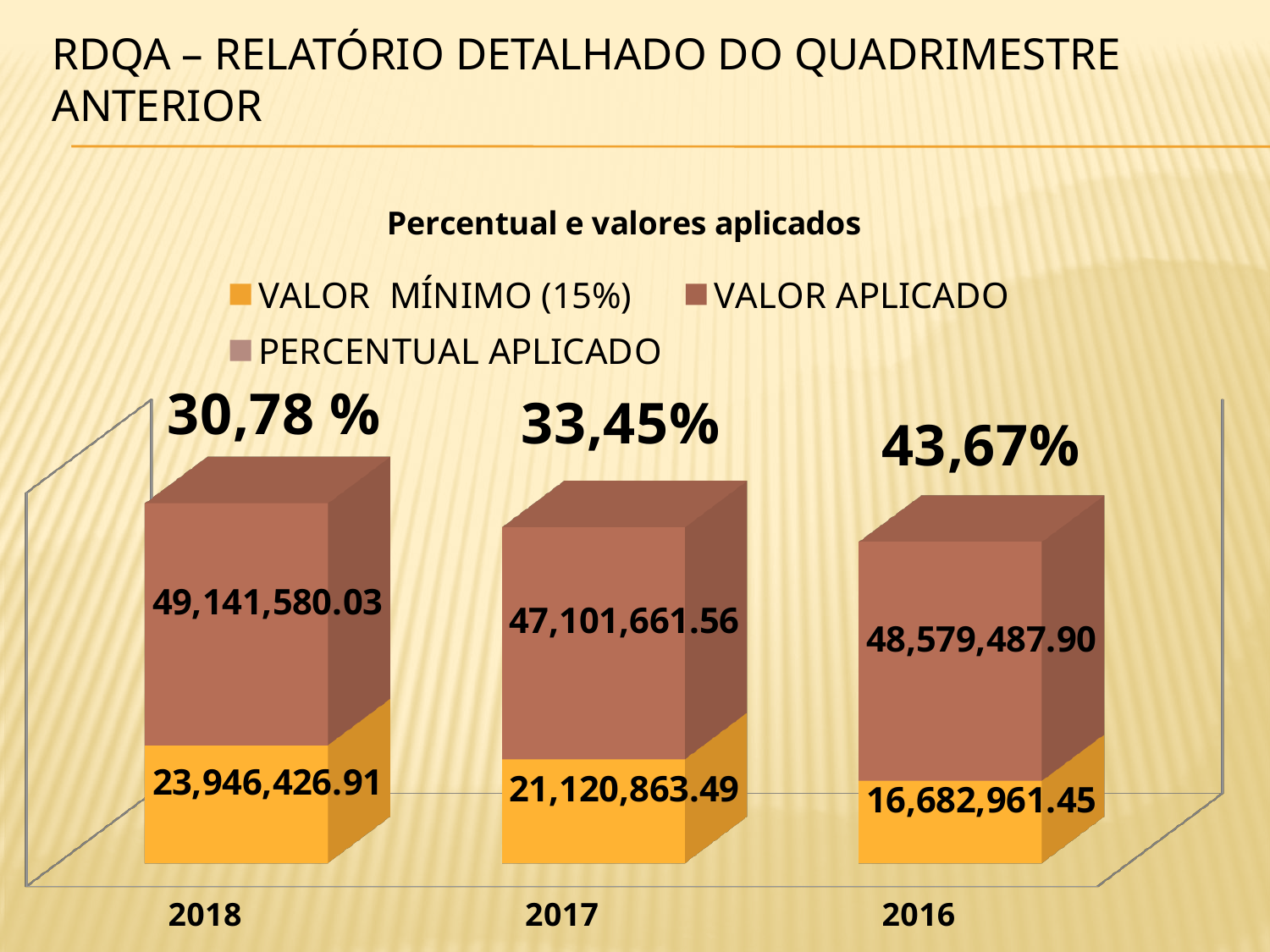
What type of chart is shown on the slide? Stacked bar chart What is the total of the stacked bar for 2017 (VALOR MÍNIMO plus VALOR APLICADO)? 68,222,525.05 What is the title of the chart? Percentual e valores aplicados Which year has the lowest VALOR APLICADO? 2017 How many years (categories) are shown on the x axis? 3 What is the difference between the VALOR APLICADO for 2018 and for 2017? 2,039,918.47 What is the VALOR MÍNIMO (15%) for 2016? 16,682,961.45 Is the VALOR APLICADO for 2016 larger or smaller than the VALOR APLICADO for 2017? Larger What is the VALOR APLICADO for 2018? 49,141,580.03 How many series does the legend list? 3 What is the PERCENTUAL APLICADO shown for 2017? 33,45% Which year has the highest VALOR MÍNIMO (15%)? 2018